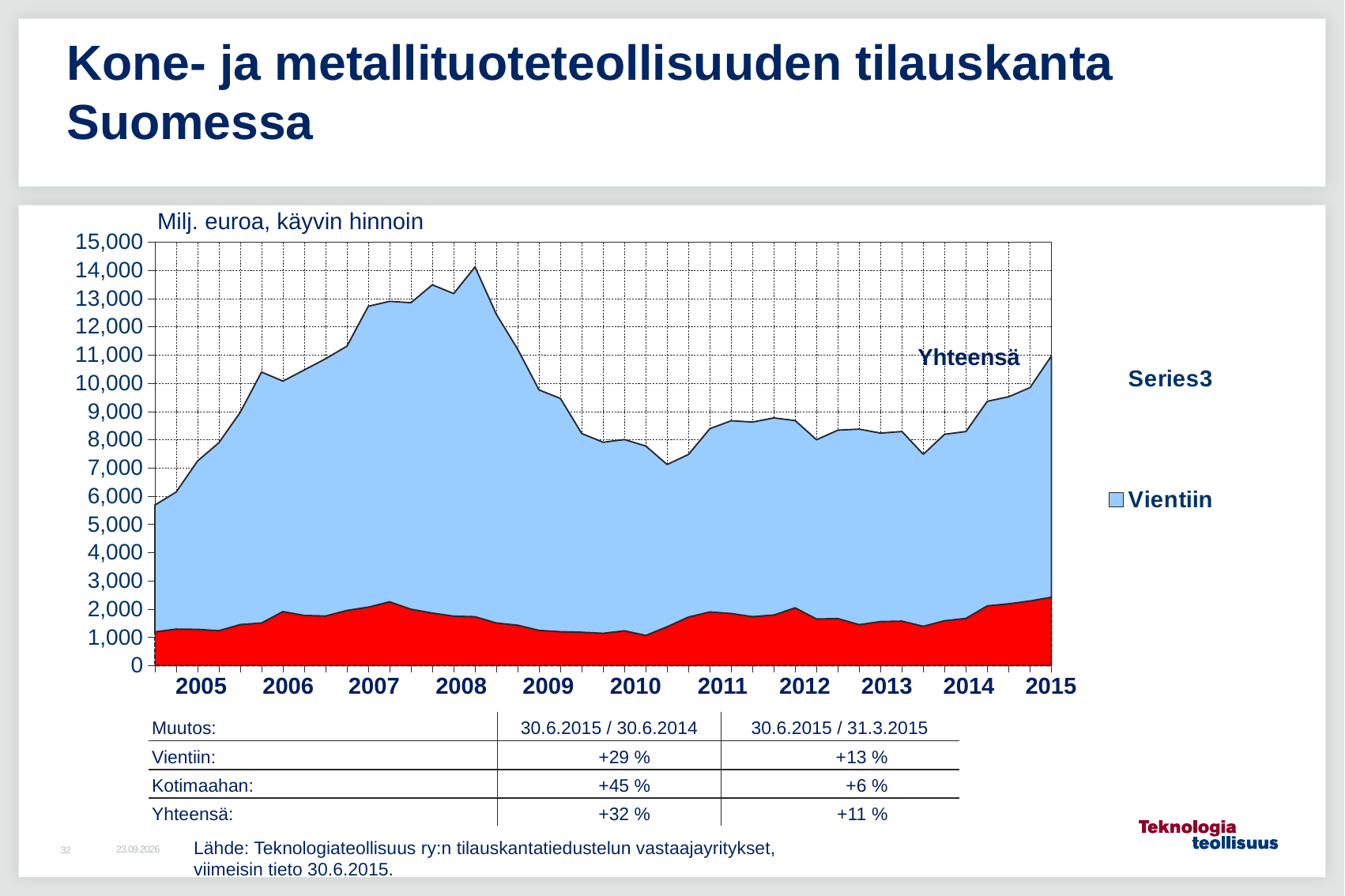
What kind of chart is shown on the slide? area chart How many year labels are shown on the x axis of the chart? 11 Which legend entry is shown with a light blue colour? Vientiin Is the peak total (Yhteensä) value in 2008 greater or less than 13,000? greater Is the lowest total (Yhteensä) value in 2010 greater or less than 8,000? less Is the total (Yhteensä) value at the end of 2015 greater or less than 10,000? greater Does the total (Yhteensä) value rise or fall from its 2008 peak to 2010? fall How many series does the chart legend list? 2 What is the unit label shown above the chart? Milj. euroa, käyvin hinnoin Does the total (Yhteensä) value rise or fall from mid-2013 to 2015? rise